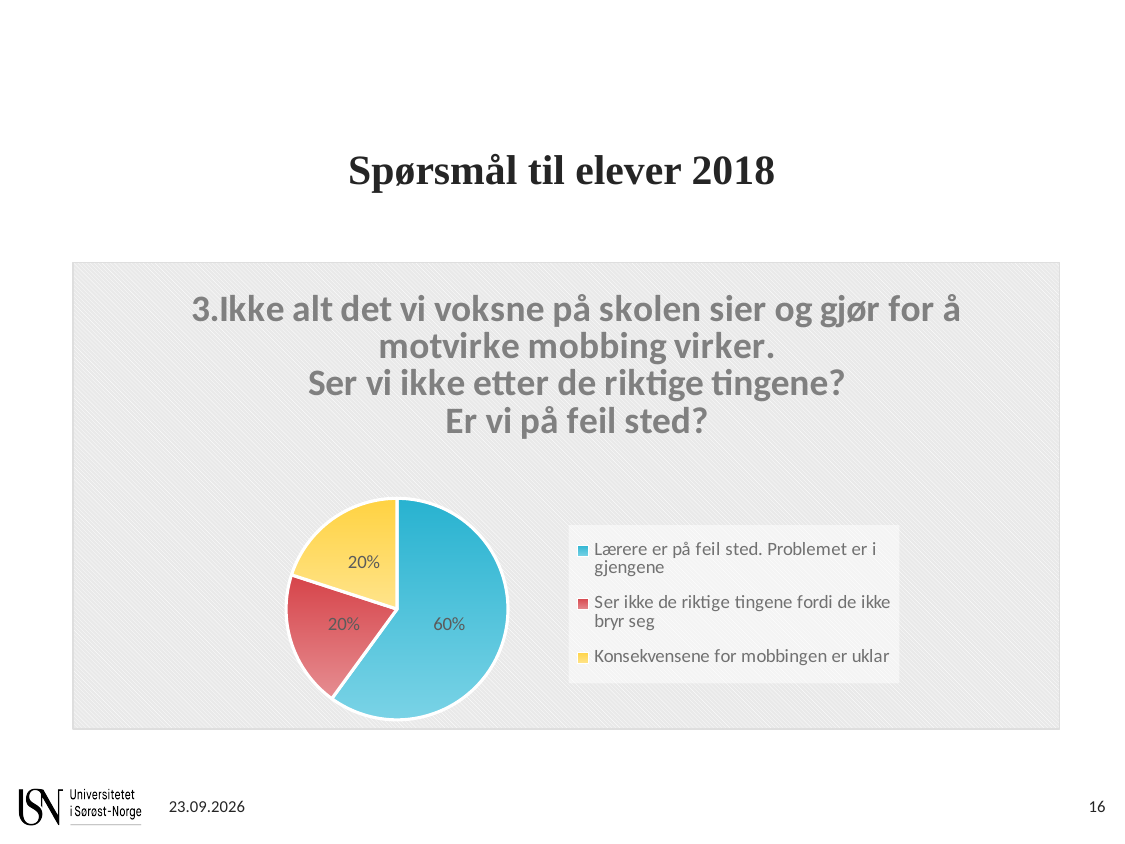
What is the difference in percentage points between the slice for "Lærere er på feil sted. Problemet er i gjengene" and the slice for "Konsekvensene for mobbingen er uklar"? 40 percentage points What kind of chart is shown on the slide? pie chart What share of the pie does "Konsekvensene for mobbingen er uklar" have? 20% Which category has the largest slice of the pie? Lærere er på feil sted. Problemet er i gjengene How many slices does the pie chart have? 3 What share of the pie does "Lærere er på feil sted. Problemet er i gjengene" have? 60% What is the combined share of the two 20% slices? 40% What share of the pie does "Ser ikke de riktige tingene fordi de ikke bryr seg" have? 20% How many entries does the legend list? 3 What colour is the largest slice of the pie? blue Which is larger: the slice for "Lærere er på feil sted. Problemet er i gjengene" or the slice for "Ser ikke de riktige tingene fordi de ikke bryr seg"? Lærere er på feil sted. Problemet er i gjengene What colour is the slice for "Konsekvensene for mobbingen er uklar"? yellow